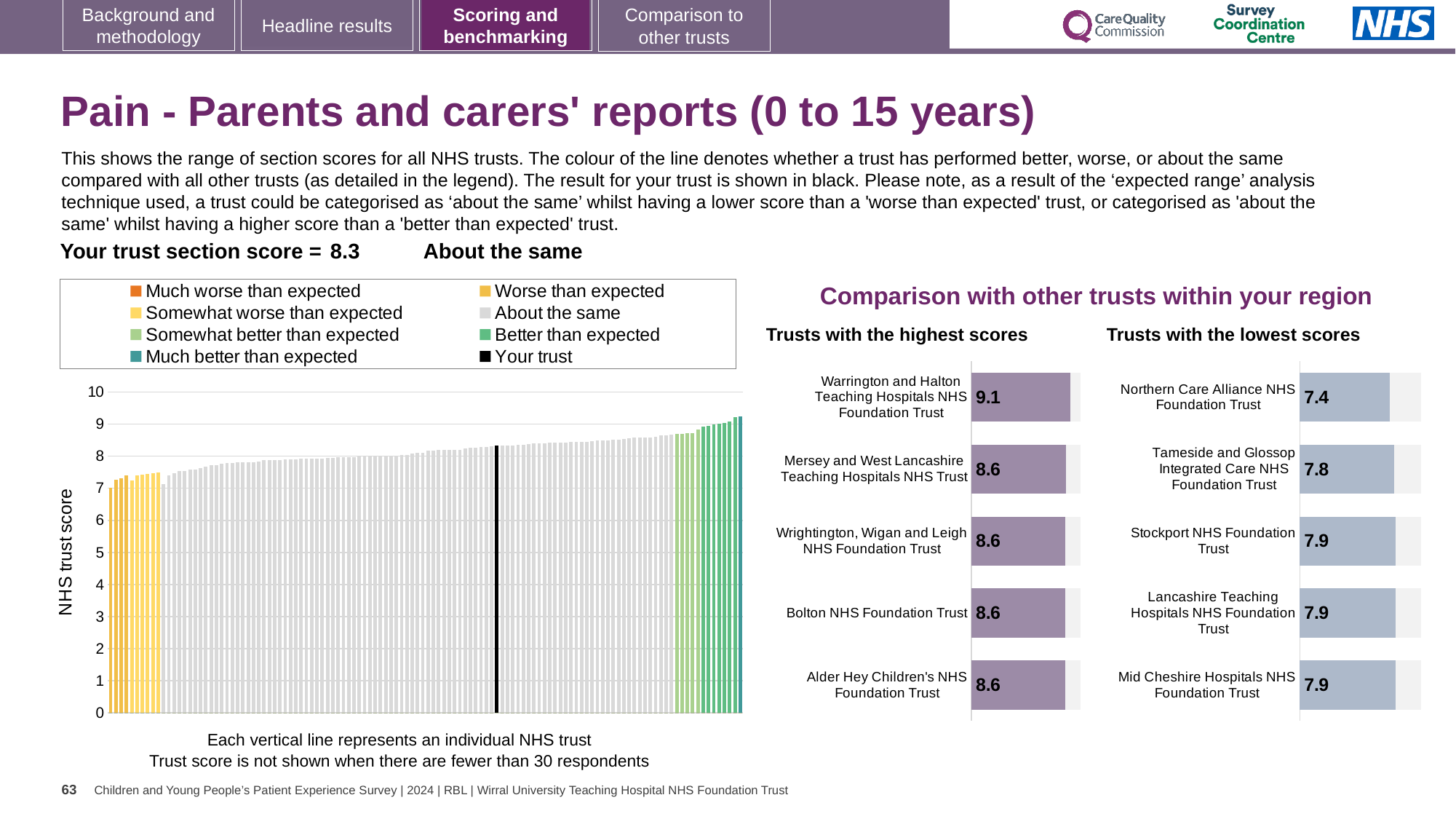
In the 'Trusts with the lowest scores' chart, what is the score for Northern Care Alliance NHS Foundation Trust? 7.4 Which is larger: the score for Warrington and Halton Teaching Hospitals NHS Foundation Trust in the 'highest scores' chart or the score for Northern Care Alliance NHS Foundation Trust in the 'lowest scores' chart? Warrington and Halton Teaching Hospitals NHS Foundation Trust In the large chart on the left, is the value for 'Your trust' (the black bar) greater or less than 8? greater In the 'Trusts with the lowest scores' chart, what is the score for Tameside and Glossop Integrated Care NHS Foundation Trust? 7.8 In the 'Trusts with the lowest scores' chart, which trust has the lowest score? Northern Care Alliance NHS Foundation Trust In the 'Trusts with the highest scores' chart, what is the score for Warrington and Halton Teaching Hospitals NHS Foundation Trust? 9.1 In the 'Trusts with the highest scores' chart, which trust has the highest score? Warrington and Halton Teaching Hospitals NHS Foundation Trust How many entries does the legend above the large chart on the left list? 8 In the 'Trusts with the lowest scores' chart, what is the difference between the score for Stockport NHS Foundation Trust and the score for Northern Care Alliance NHS Foundation Trust? 0.5 How many trusts are shown in the 'Trusts with the highest scores' chart? 5 In the 'Trusts with the highest scores' chart, what is the difference between the score for Warrington and Halton Teaching Hospitals NHS Foundation Trust and the score for Bolton NHS Foundation Trust? 0.5 What kind of chart is the large chart on the left showing NHS trust scores? Bar chart